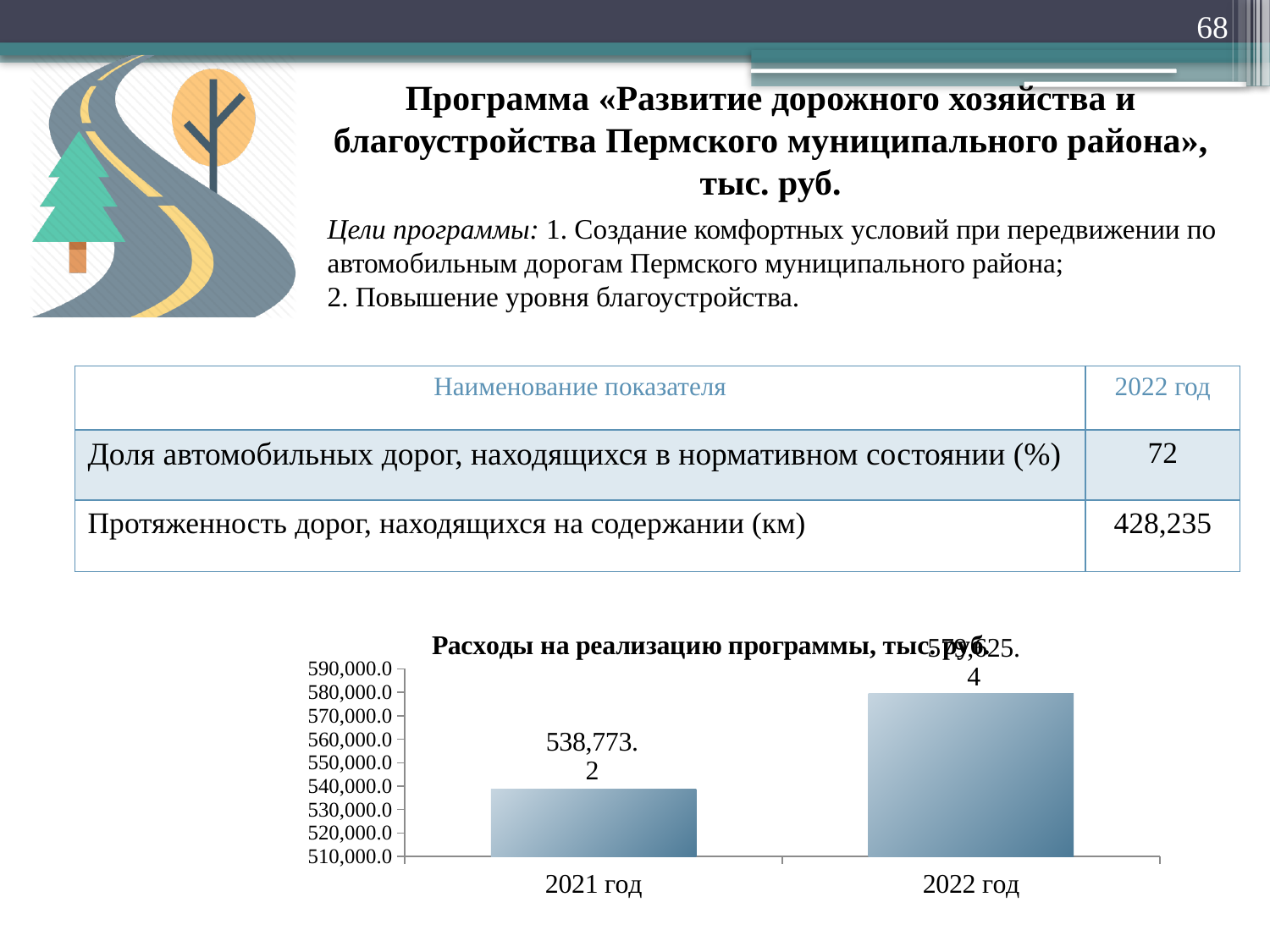
What is the value for 2022 год in the chart? 579,625.4 Is the value for 2021 год greater or less than 550,000.0? less What is the value for 2021 год in the chart? 538,773.2 Is the value for 2022 год greater or less than 570,000.0? greater What is the lowest value shown on the chart's vertical axis? 510,000.0 Which year has the lowest expenditure in the chart? 2021 год Which year has the highest expenditure in the chart? 2022 год How many bars (categories) does the chart show? 2 What is the title of the chart? Расходы на реализацию программы, тыс. руб. What kind of chart is shown on the slide? bar chart Which is larger, the value for 2021 год or for 2022 год? 2022 год Do the values rise or fall from 2021 год to 2022 год? rise